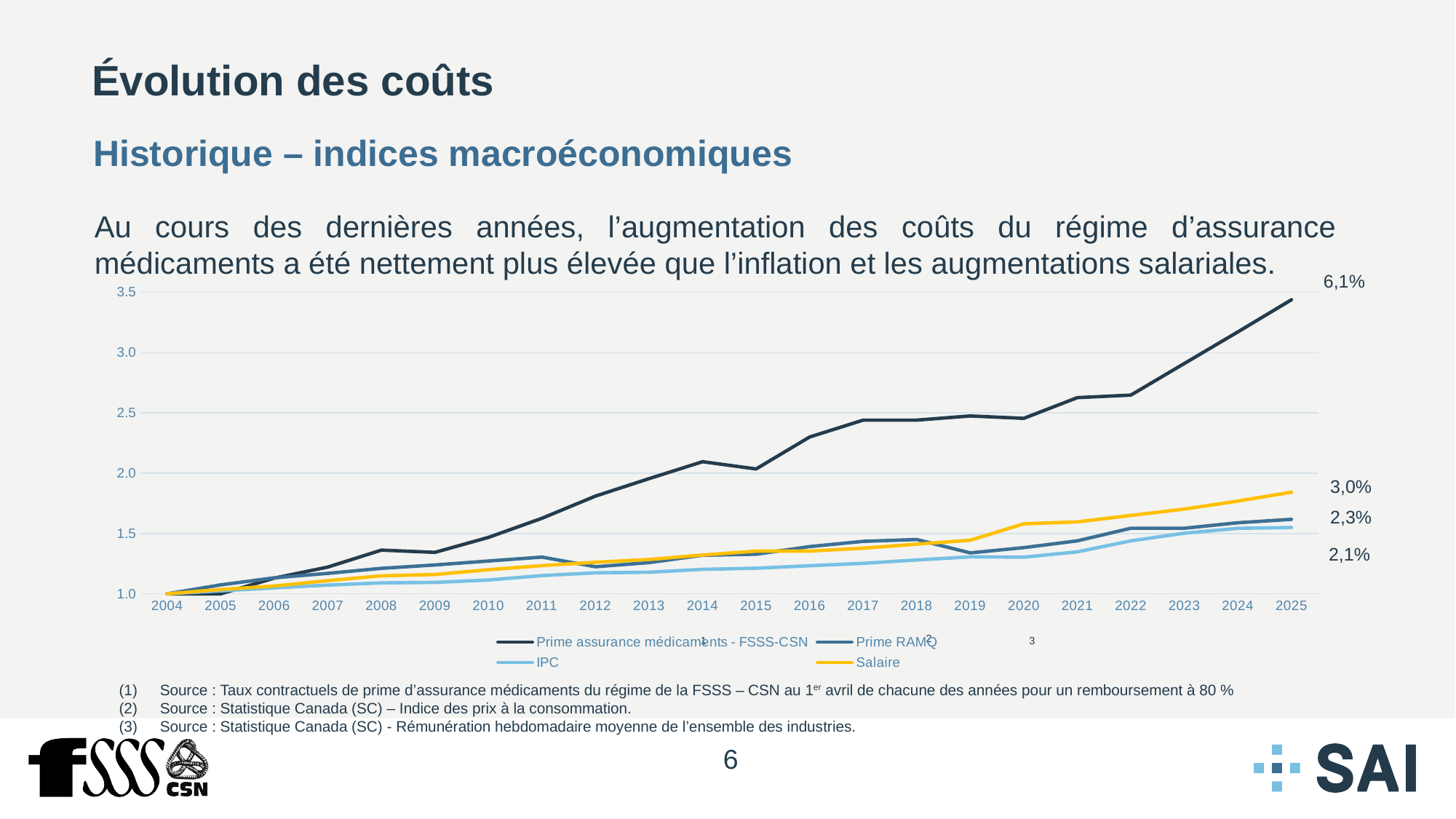
In 2025, which is larger: Salaire or IPC? Salaire How many years are shown on the x axis of the chart? 22 At what value do all four series start in 2004? 1.0 Is the value of IPC in 2020 greater or less than 1.5? less Is the value of Salaire in 2025 greater or less than 2.0? less Is the value of Prime assurance médicaments - FSSS-CSN in 2025 greater or less than 3.0? greater Does the Prime assurance médicaments - FSSS-CSN line rise or fall overall from 2004 to 2025? rise How many series does the chart legend list? 4 What kind of chart is shown on the slide? line chart What colour is the Salaire line in the chart? yellow Which series has the highest value in 2025? Prime assurance médicaments - FSSS-CSN